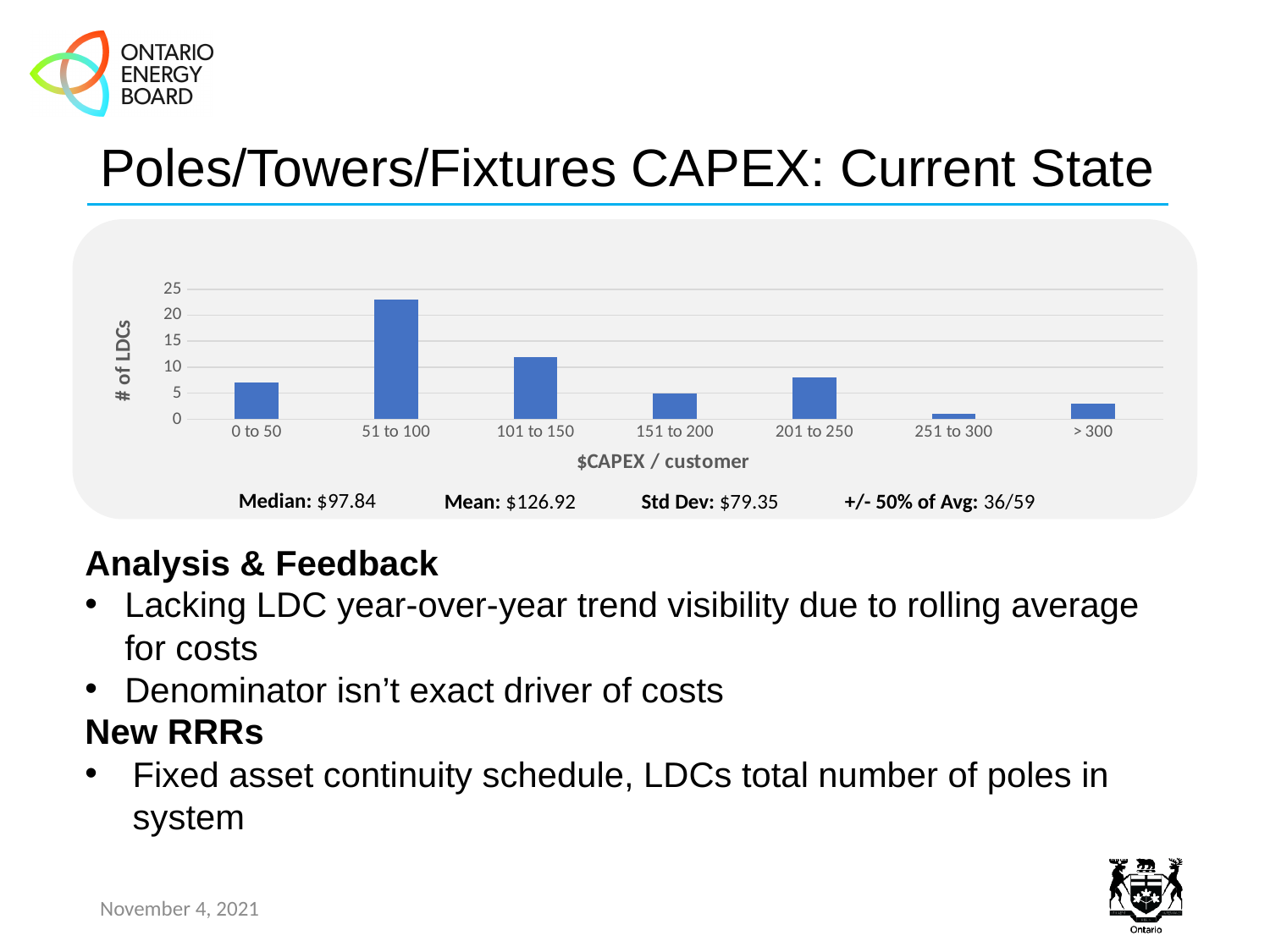
Is the number of LDCs for the > 300 category greater or less than 5? less Which category has more LDCs, 0 to 50 or > 300? 0 to 50 Is the number of LDCs for the 51 to 100 category greater or less than 20? greater Which $CAPEX / customer category has the highest number of LDCs? 51 to 100 Is the number of LDCs for the 0 to 50 category greater or less than 5? greater Which $CAPEX / customer category has the lowest number of LDCs? 251 to 300 Which category has more LDCs, 101 to 150 or 201 to 250? 101 to 150 What kind of chart is shown on the slide? bar chart How many $CAPEX / customer categories are shown on the x axis? 7 What is the label of the y axis of the chart? # of LDCs